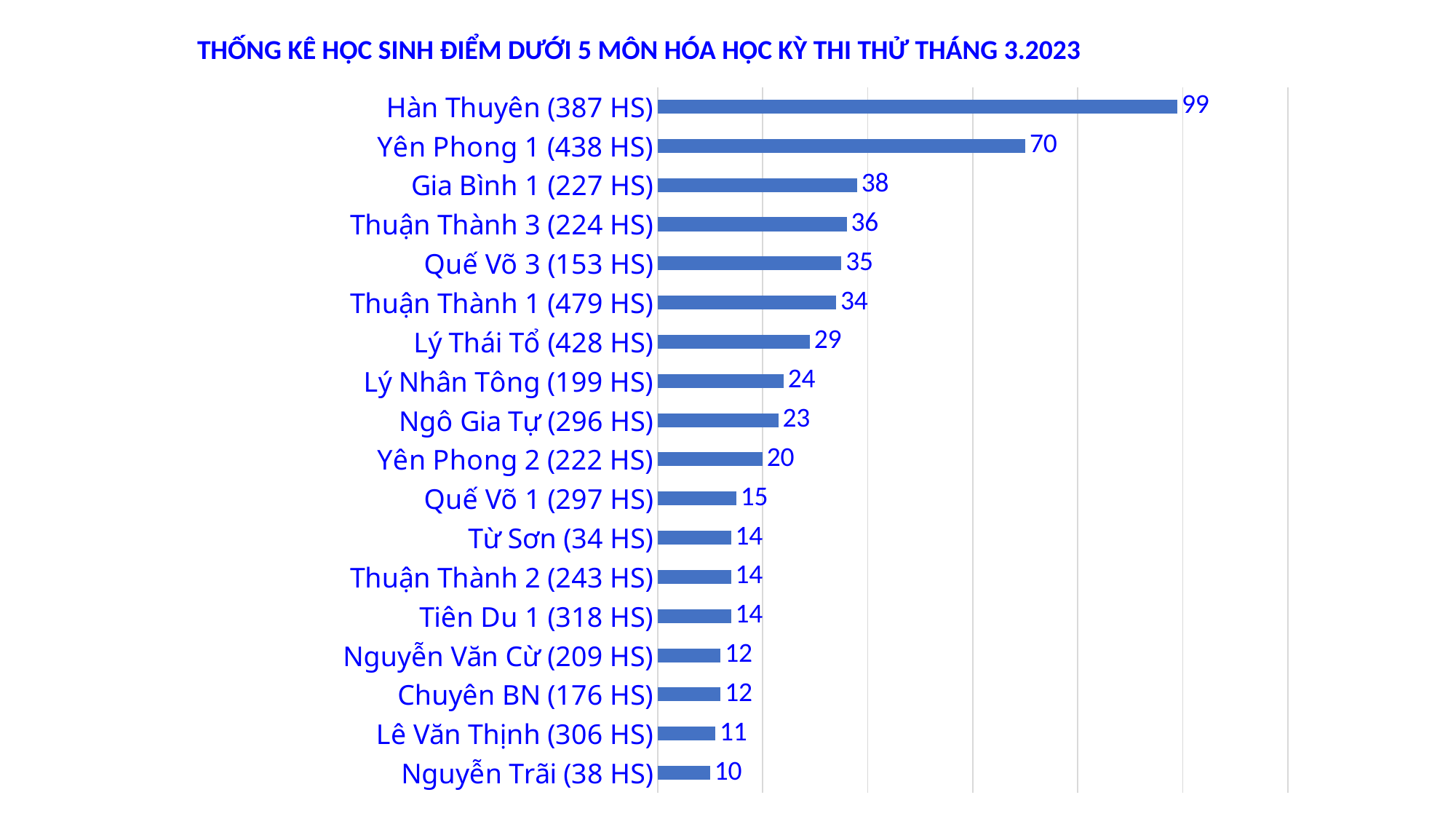
What is the value for Hàn Thuyên (387 HS)? 99 What is the difference between the values for Gia Bình 1 (227 HS) and Quế Võ 1 (297 HS)? 23 What kind of chart is shown on the slide? Bar chart What is the value for Lý Thái Tổ (428 HS)? 29 What is the difference between the values for Hàn Thuyên (387 HS) and Yên Phong 1 (438 HS)? 29 Which is larger, the value for Yên Phong 2 (222 HS) or the value for Lê Văn Thịnh (306 HS)? Yên Phong 2 (222 HS) Which is larger, the value for Thuận Thành 3 (224 HS) or the value for Ngô Gia Tự (296 HS)? Thuận Thành 3 (224 HS) What is the value for Chuyên BN (176 HS)? 12 Which category has the highest value? Hàn Thuyên (387 HS) Which category has the lowest value? Nguyễn Trãi (38 HS) How many categories are shown in the chart? 18 What is the title of the chart? THỐNG KÊ HỌC SINH ĐIỂM DƯỚI 5 MÔN HÓA HỌC KỲ THI THỬ THÁNG 3.2023